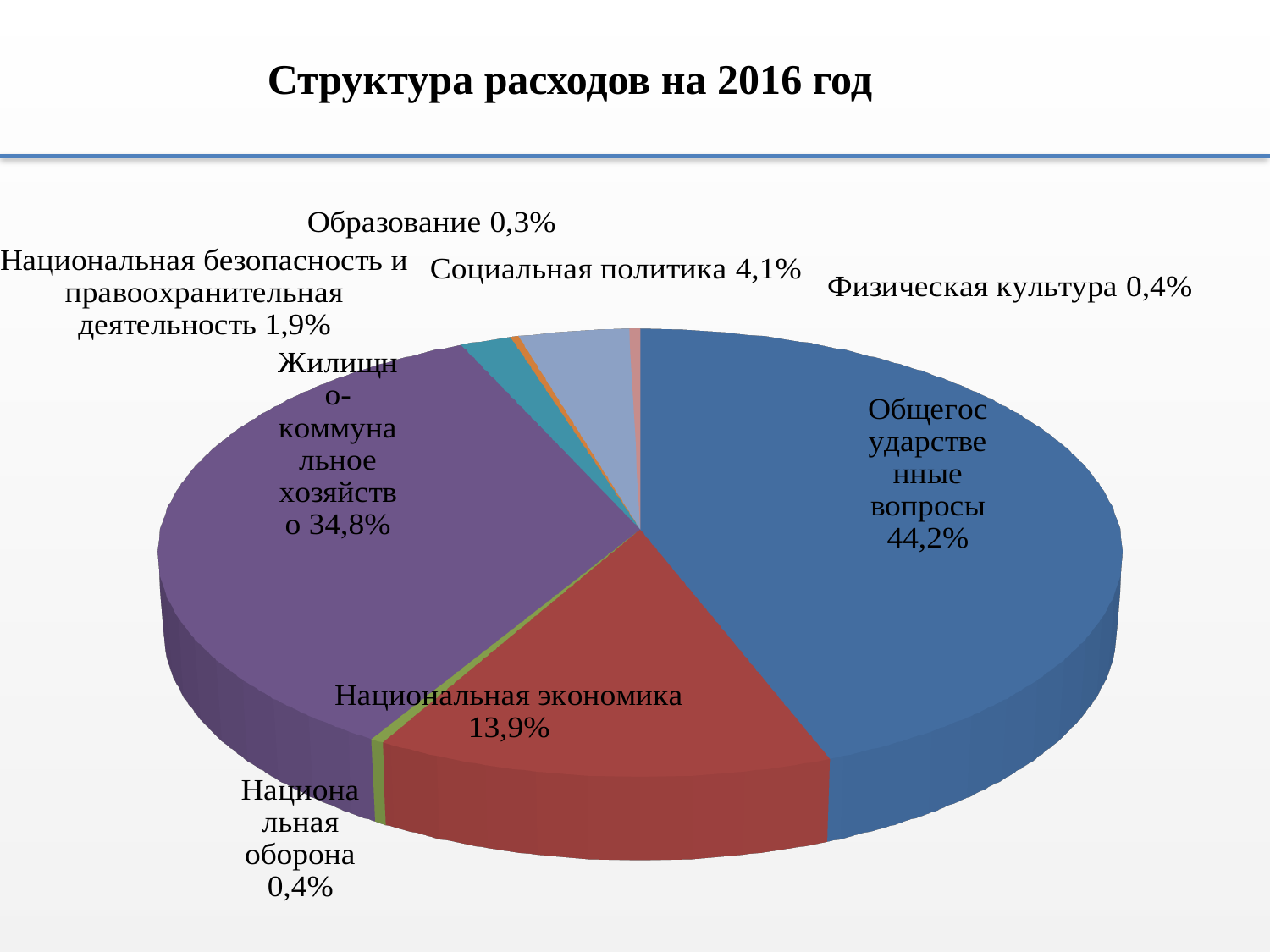
What kind of chart is shown on the slide? pie chart What share of expenditure goes to Общегосударственные вопросы? 44,2% Which category has the largest share of the pie? Общегосударственные вопросы What share of expenditure goes to Национальная экономика? 13,9% What is the title of the chart? Структура расходов на 2016 год What share of expenditure goes to Национальная безопасность и правоохранительная деятельность? 1,9% What share of expenditure goes to Социальная политика? 4,1% What is the difference in percentage points between Общегосударственные вопросы and Жилищно-коммунальное хозяйство? 9,4 Which category has the smallest share of the pie? Образование How many categories are shown in the pie chart? 8 Which is larger, the share for Национальная экономика or the share for Социальная политика? Национальная экономика What share of expenditure goes to Жилищно-коммунальное хозяйство? 34,8%